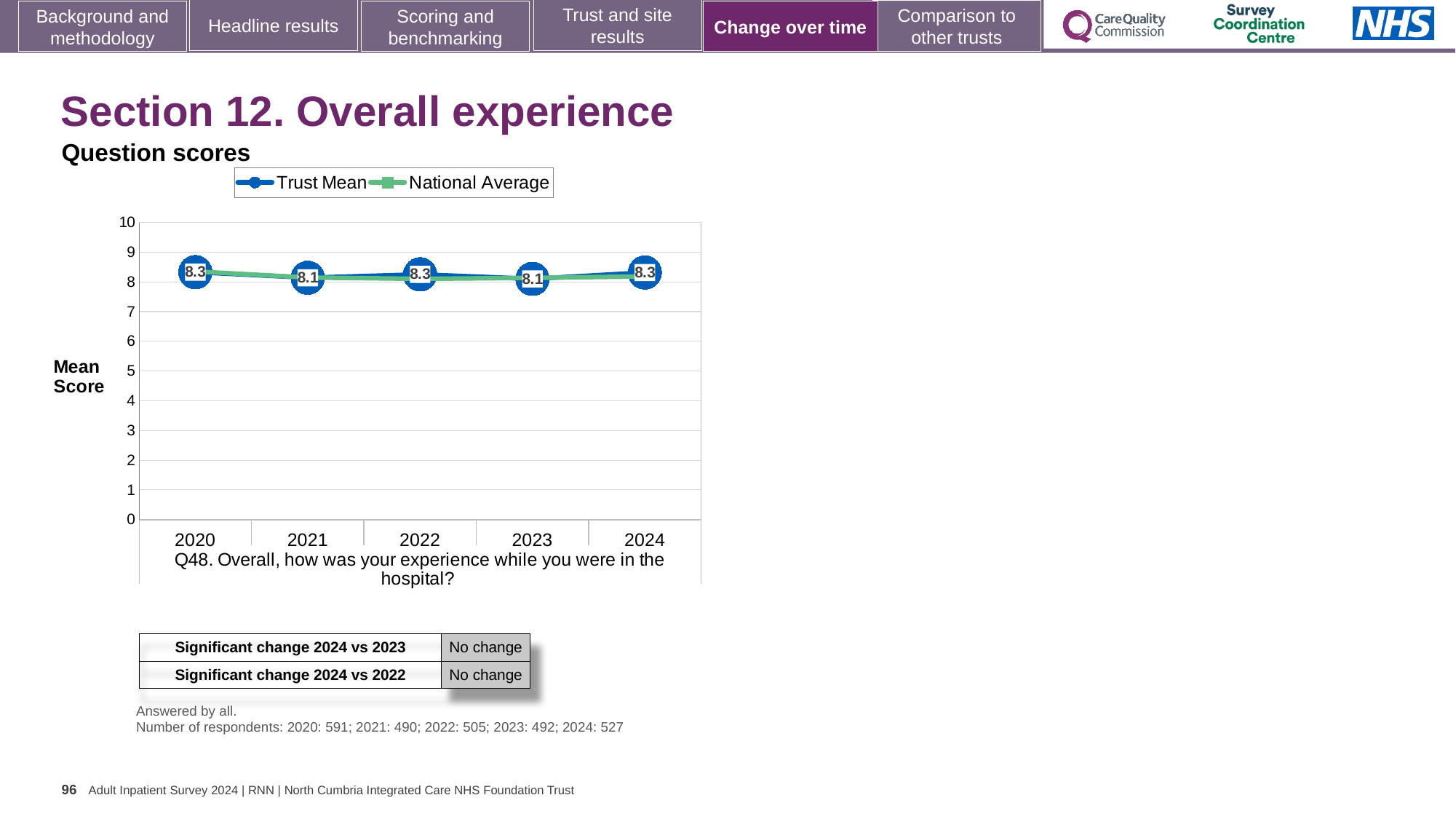
What is the label on the y axis? Mean Score What is the Trust Mean score for 2023? 8.1 Which is larger, the Trust Mean score for 2022 or for 2023? 2022 Is the Trust Mean score for 2021 greater or less than 7? greater What is the Trust Mean score for 2024? 8.3 What kind of chart is shown? Line chart What is the Trust Mean score for 2021? 8.1 How many series does the legend list? 2 Which series is shown in green in the legend? National Average What is the Trust Mean score for 2020? 8.3 What is the difference between the Trust Mean scores for 2020 and 2021? 0.2 How many years are plotted on the x axis? 5